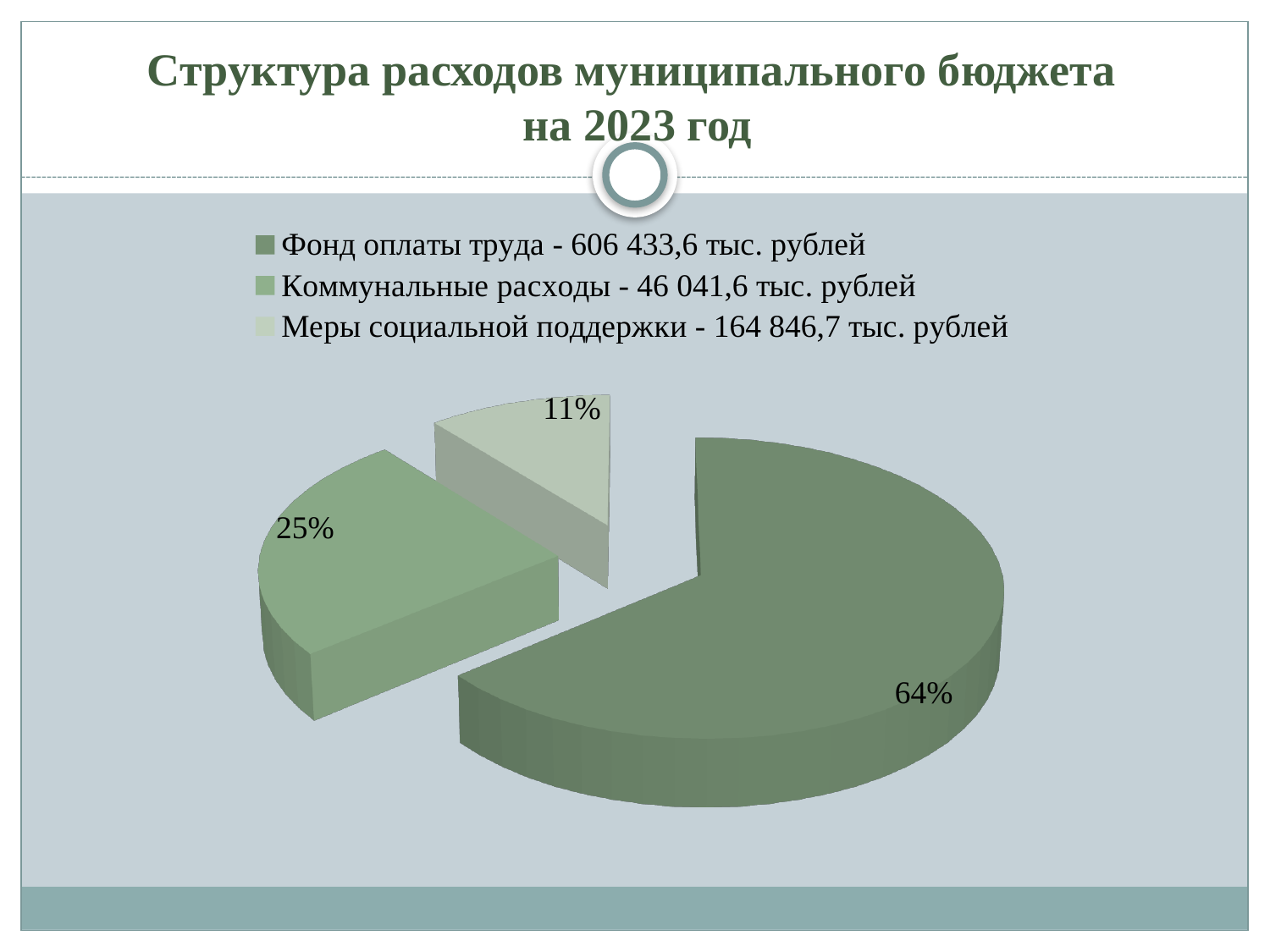
What amount does the legend give for "Фонд оплаты труда"? 606 433,6 тыс. рублей What share of the pie does "Фонд оплаты труда" take? 64% How many slices does the pie chart have? 3 By how many percentage points does the "Фонд оплаты труда" slice exceed the "Коммунальные расходы" slice? 39 percentage points What share of the pie does "Меры социальной поддержки" take? 11% Which slice is larger: "Коммунальные расходы" or "Меры социальной поддержки"? Коммунальные расходы What is the title of the slide's chart? Структура расходов муниципального бюджета на 2023 год What kind of chart is shown on the slide? Pie chart Which category has the largest slice of the pie? Фонд оплаты труда How many entries does the legend list? 3 What share of the pie does "Коммунальные расходы" take? 25% Which category has the smallest slice of the pie? Меры социальной поддержки